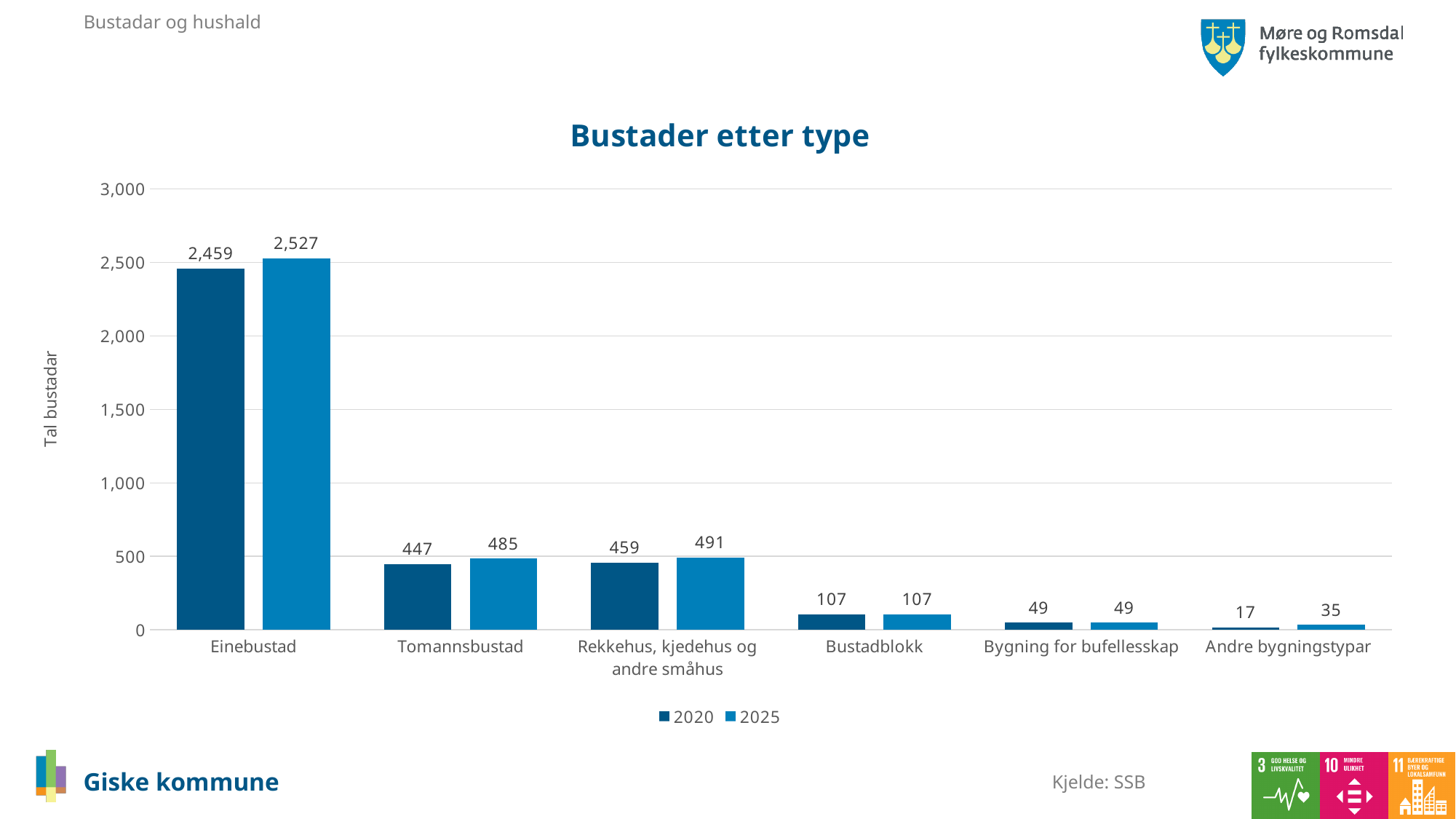
How many categories are shown on the x axis? 6 Which is larger: the 2025 value for Tomannsbustad or the 2025 value for Rekkehus, kjedehus og andre småhus? Rekkehus, kjedehus og andre småhus How many series does the legend list? 2 What is the difference between the 2025 and 2020 values for Einebustad? 68 What is the value for Andre bygningstypar in 2025? 35 What kind of chart is shown on the slide? Bar chart What is the value for Einebustad in 2025? 2,527 What is the title of the chart? Bustader etter type Which category has the highest value in 2020? Einebustad What is the value for Tomannsbustad in 2020? 447 Which category has the lowest value in 2025? Andre bygningstypar What is the difference between the 2025 and 2020 values for Rekkehus, kjedehus og andre småhus? 32